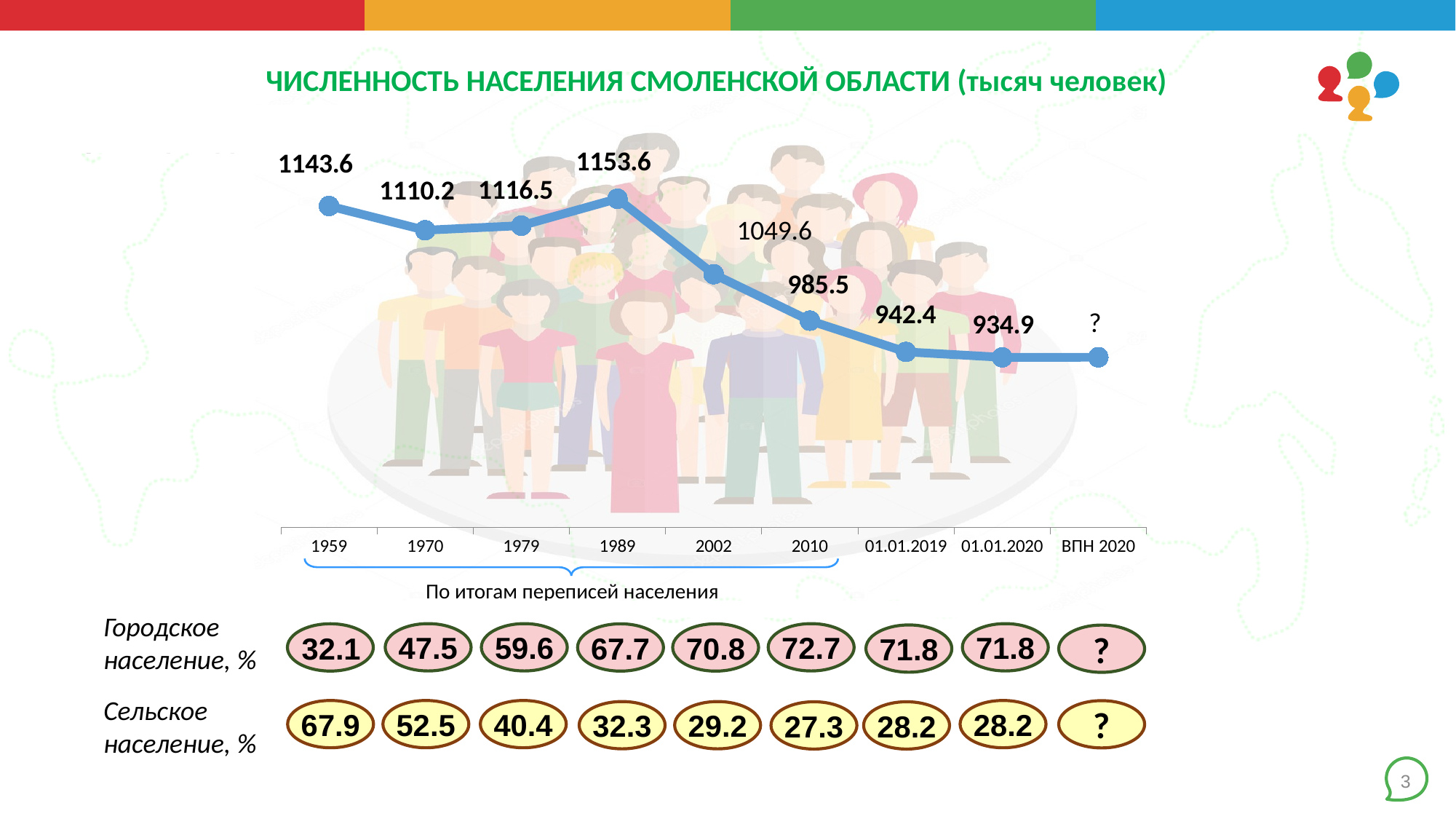
Which labelled point has the lowest population value on the chart? 01.01.2020 What is the population value shown for 1989? 1153.6 Do the population values rise or fall from 1989 to 01.01.2020? fall Which is larger, the population value for 1970 or for 1979? 1979 What kind of chart is shown on the slide? line chart Which year has the highest population value on the chart? 1989 What is the difference between the population values for 1989 and 2002? 104.0 What label is shown for the last point on the x axis, ВПН 2020? ? How many points are marked along the x axis of the chart? 9 What is the population value shown for 2002? 1049.6 What is the difference between the population values for 1959 and 01.01.2020? 208.7 What is the population value shown for 01.01.2020? 934.9